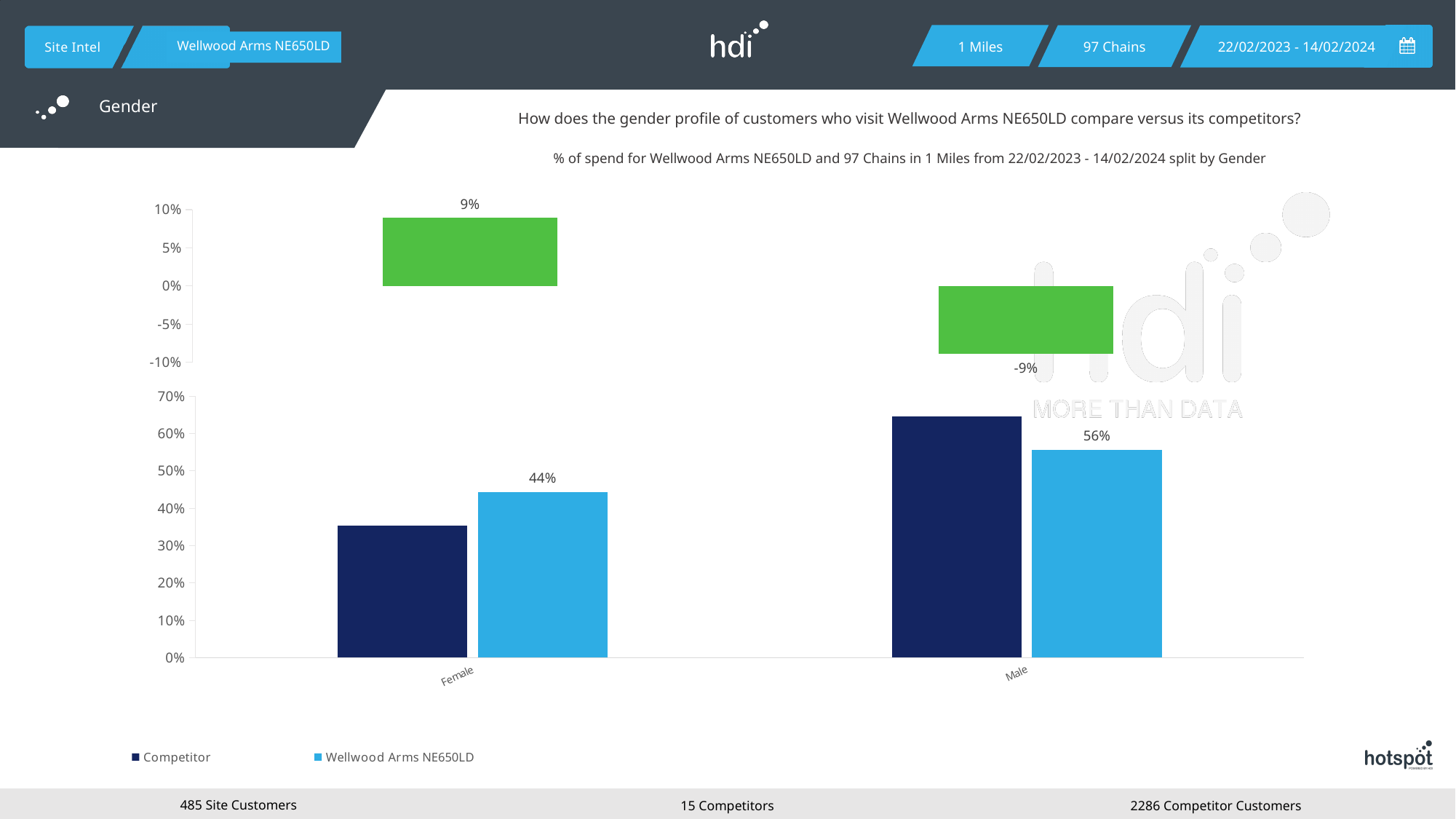
In the bottom chart, is the Competitor value for Female greater or less than 40%? less In the bottom chart, what is the value for Wellwood Arms NE650LD for Female? 44% In the bottom chart, what is the value for Wellwood Arms NE650LD for Male? 56% In the bottom chart, what is the difference between the Wellwood Arms NE650LD values for Male and Female? 12% How many series does the legend of the bottom chart list? 2 In the top chart, what is the value shown for Female? 9% In the bottom chart, which gender has the higher value for Wellwood Arms NE650LD? Male In the bottom chart, is the Competitor value for Male greater or less than 60%? greater What type of chart is the bottom chart? Bar chart In the top chart, what is the value shown for Male? -9% In the bottom chart, for Female, which is larger: the Competitor value or the Wellwood Arms NE650LD value? Wellwood Arms NE650LD In the bottom chart, for Male, which is larger: the Competitor value or the Wellwood Arms NE650LD value? Competitor